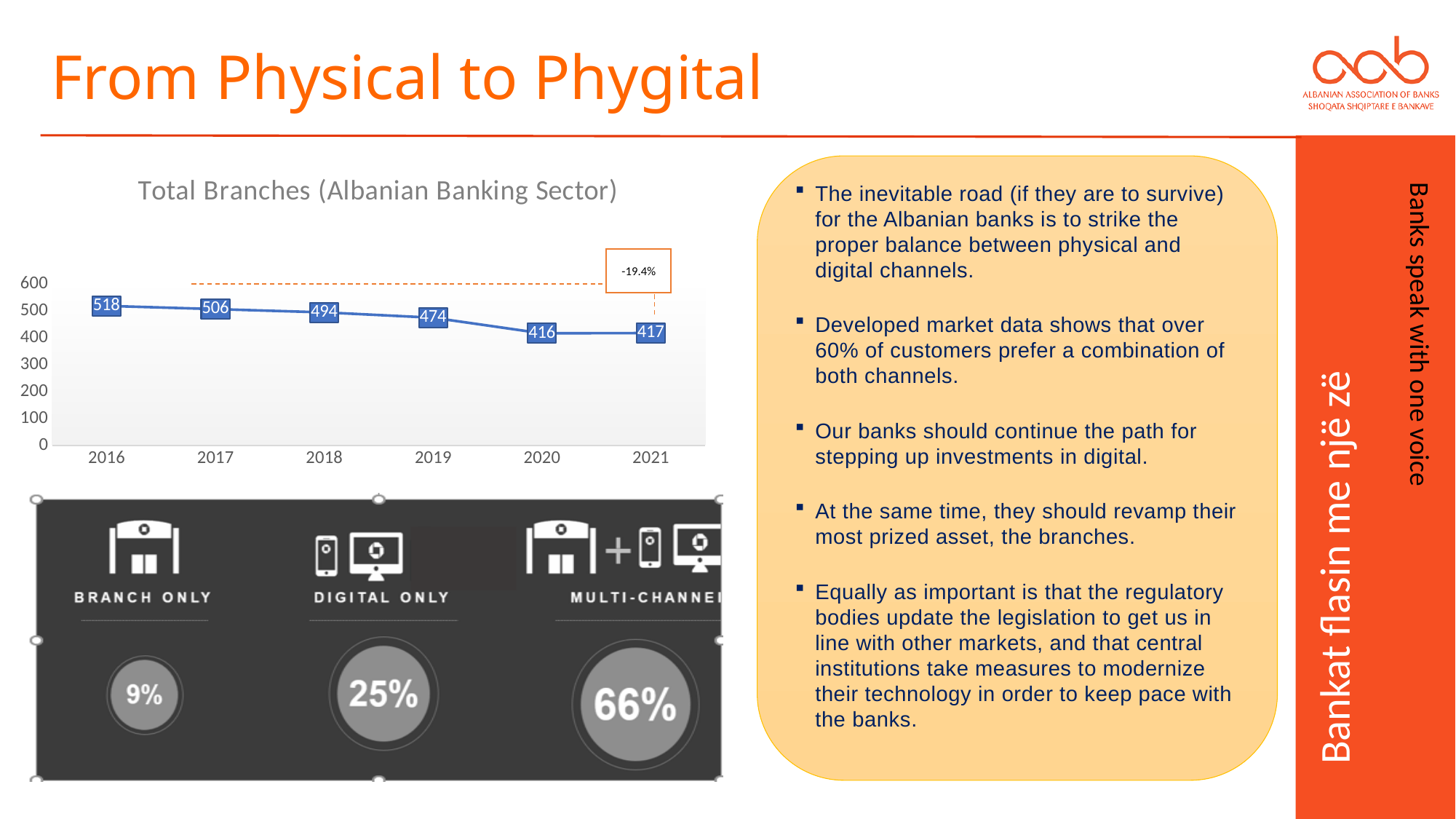
In the 'Total Branches (Albanian Banking Sector)' chart, which year has the lowest number of branches? 2020 In the 'Total Branches (Albanian Banking Sector)' chart, how many years are plotted? 6 In the 'Total Branches (Albanian Banking Sector)' chart, what is the value for 2016? 518 In the 'Total Branches (Albanian Banking Sector)' chart, what is the value for 2019? 474 In the 'Total Branches (Albanian Banking Sector)' chart, which is larger, the value for 2017 or the value for 2018? 2017 In the 'Total Branches (Albanian Banking Sector)' chart, do the values generally rise or fall from 2016 to 2021? fall What percentage change is shown in the annotation box on the 'Total Branches (Albanian Banking Sector)' chart? -19.4% What kind of chart is 'Total Branches (Albanian Banking Sector)'? line chart In the 'Total Branches (Albanian Banking Sector)' chart, which year has the highest number of branches? 2016 In the 'Total Branches (Albanian Banking Sector)' chart, what is the value for 2021? 417 In the 'Total Branches (Albanian Banking Sector)' chart, what is the difference between the 2018 and 2019 values? 20 In the 'Total Branches (Albanian Banking Sector)' chart, what is the difference between the 2016 and 2021 values? 101